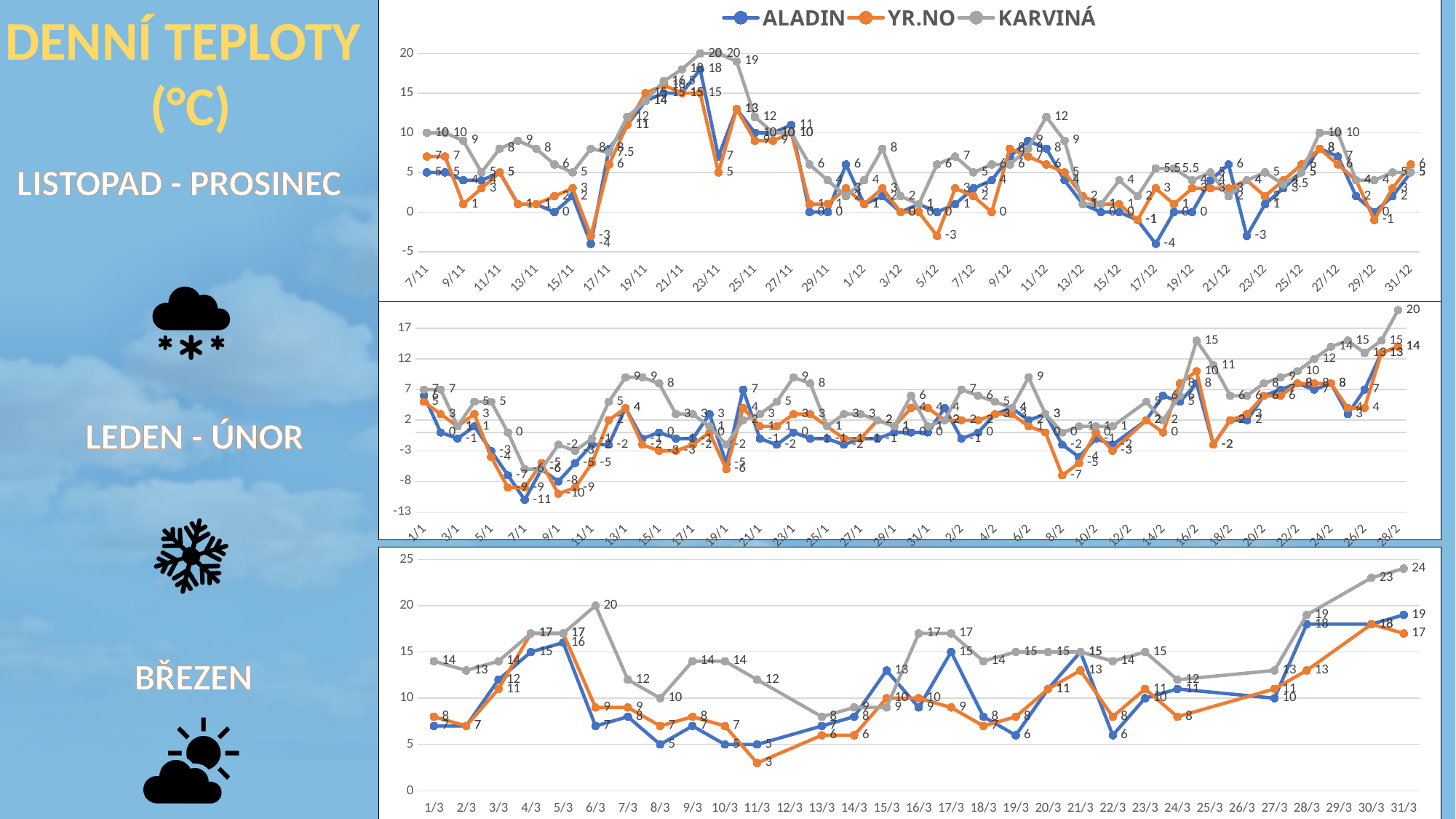
In the bottom chart (Březen), which series has the higher value on 6/3, KARVINÁ or ALADIN? KARVINÁ How many series does the legend at the top of the slide list? 3 In the bottom chart (Březen), is the KARVINÁ value on 30/3 greater or less than 20? greater In the top chart (Listopad - Prosinec), what is the lowest value reached by ALADIN? -4 In the bottom chart (Březen), on which date does KARVINÁ reach its highest value? 31/3 In the middle chart (Leden - Únor), what is the KARVINÁ value on 28/2? 20 What are the three series named in the legend? ALADIN, YR.NO, KARVINÁ In the bottom chart (Březen), what is the difference between the ALADIN and YR.NO values on 31/3? 2 In the bottom chart (Březen), what is the YR.NO value on 11/3? 3 In the bottom chart (Březen), what is the KARVINÁ value on 31/3? 24 What kind of chart is used on this slide for the daily temperatures? line chart In the top chart (Listopad - Prosinec), what is the ALADIN value on 23/11? 7